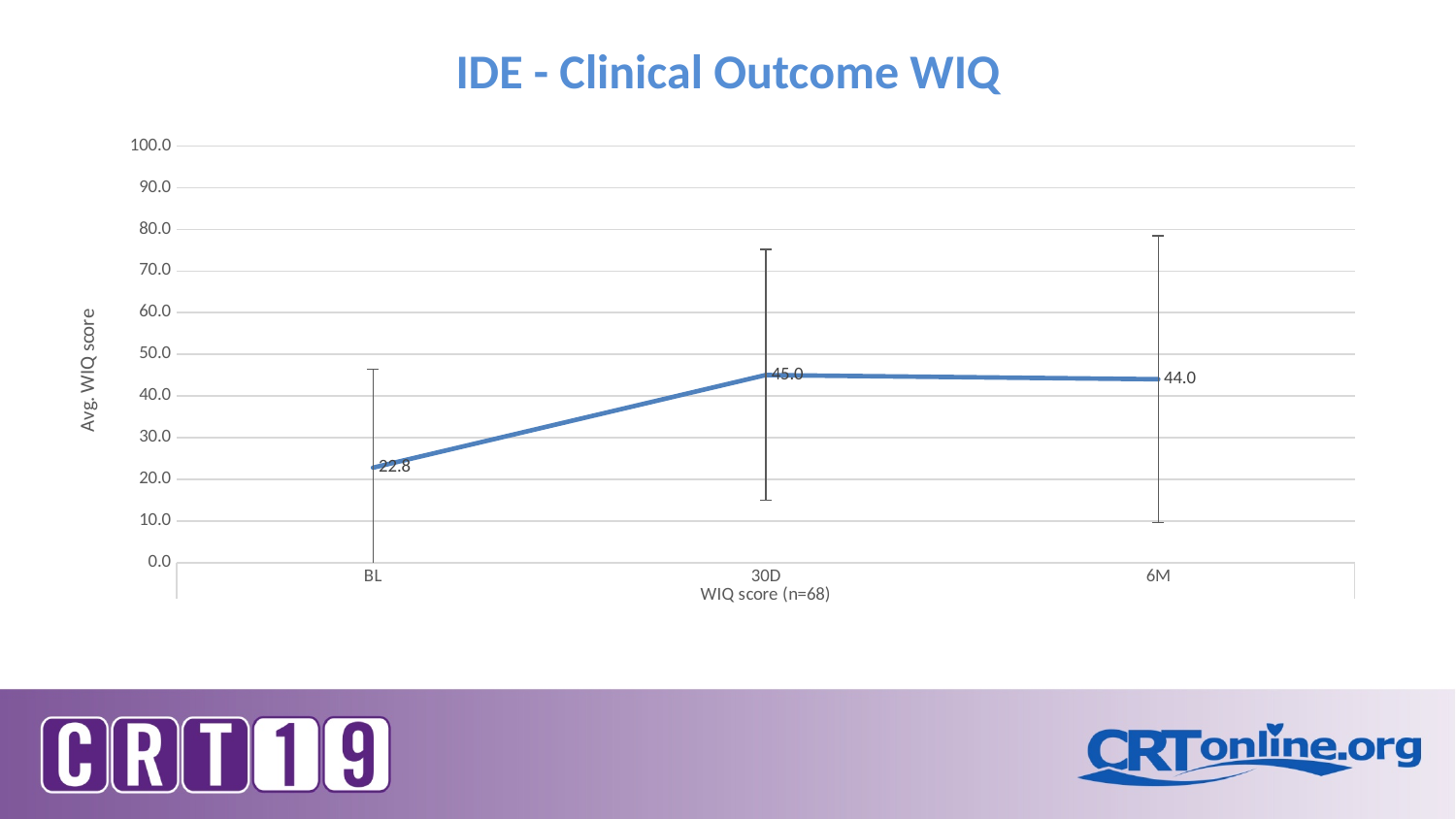
What is the average WIQ score at 6M? 44.0 What is the title of the chart? IDE - Clinical Outcome WIQ What is the difference between the average WIQ score at 30D and at BL? 22.2 What is the average WIQ score at BL? 22.8 What is the difference between the average WIQ score at 30D and at 6M? 1.0 What kind of chart is shown on the slide? line chart What is the average WIQ score at 30D? 45.0 Which is larger, the average WIQ score at BL or at 6M? 6M How many time points are plotted on the chart? 3 Which time point has the highest average WIQ score? 30D Is the average WIQ score at BL greater or less than 30.0? less Which time point has the lowest average WIQ score? BL